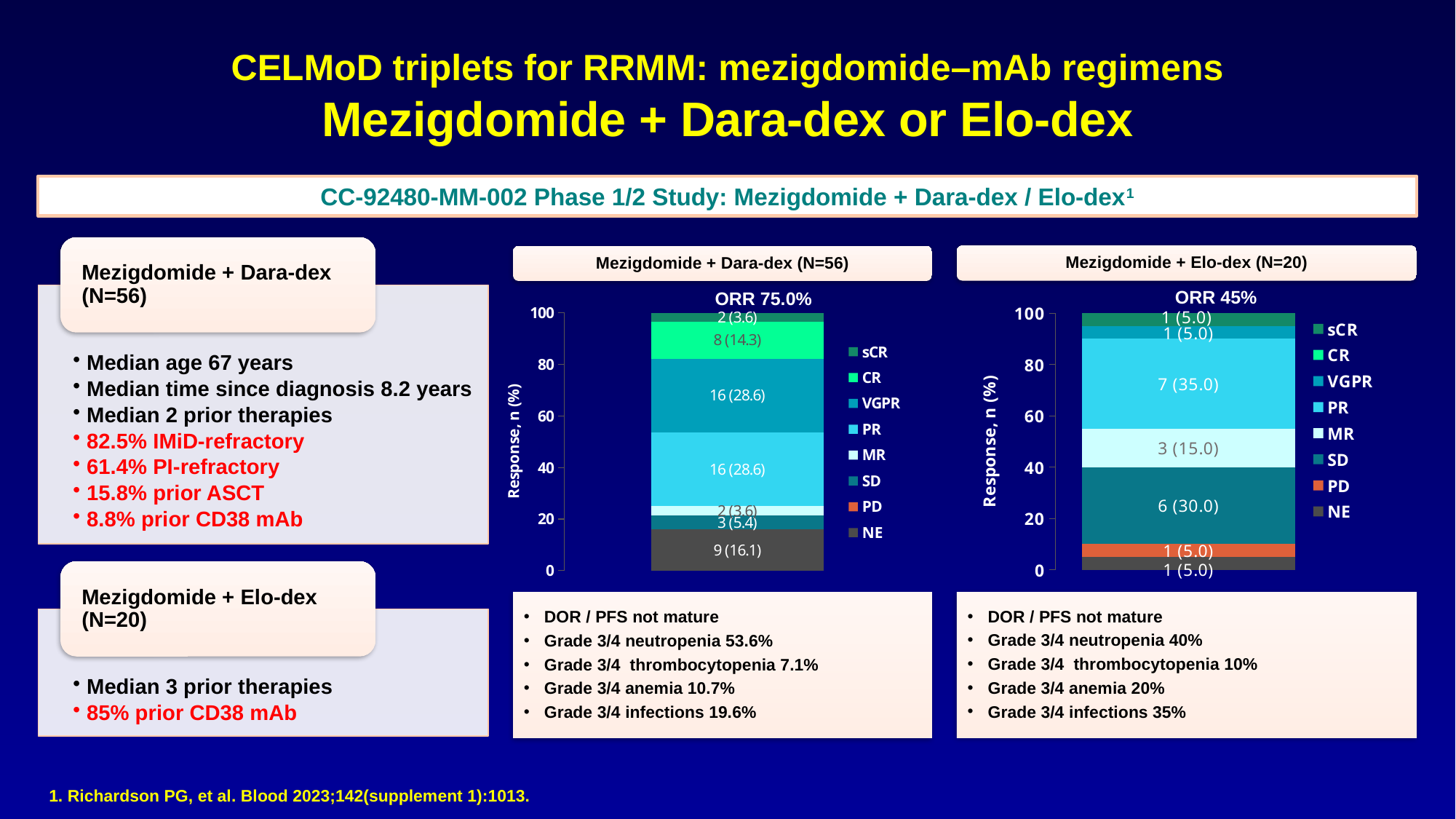
In the Mezigdomide + Elo-dex (N=20) chart, what is the label on the SD segment? 6 (30.0) What ORR is shown above the Mezigdomide + Elo-dex (N=20) chart? ORR 45% What type of chart is used to show the responses for Mezigdomide + Dara-dex (N=56)? Stacked bar chart In the Mezigdomide + Dara-dex (N=56) chart, what is the label on the VGPR segment? 16 (28.6) In the Mezigdomide + Dara-dex (N=56) chart, which is larger, the CR segment or the NE segment? NE In the Mezigdomide + Dara-dex (N=56) chart, how many more patients achieved VGPR than CR? 8 In the Mezigdomide + Dara-dex (N=56) chart, what is the label on the NE segment? 9 (16.1) In the Mezigdomide + Elo-dex (N=20) chart, what is the label on the MR segment? 3 (15.0) How many entries does the legend of the Mezigdomide + Elo-dex (N=20) chart list? 8 In the Mezigdomide + Elo-dex (N=20) chart, what is the label on the PR segment? 7 (35.0) In the Mezigdomide + Dara-dex (N=56) chart, what is the label on the CR segment? 8 (14.3) In the Mezigdomide + Elo-dex (N=20) chart, which response category has the largest segment? PR